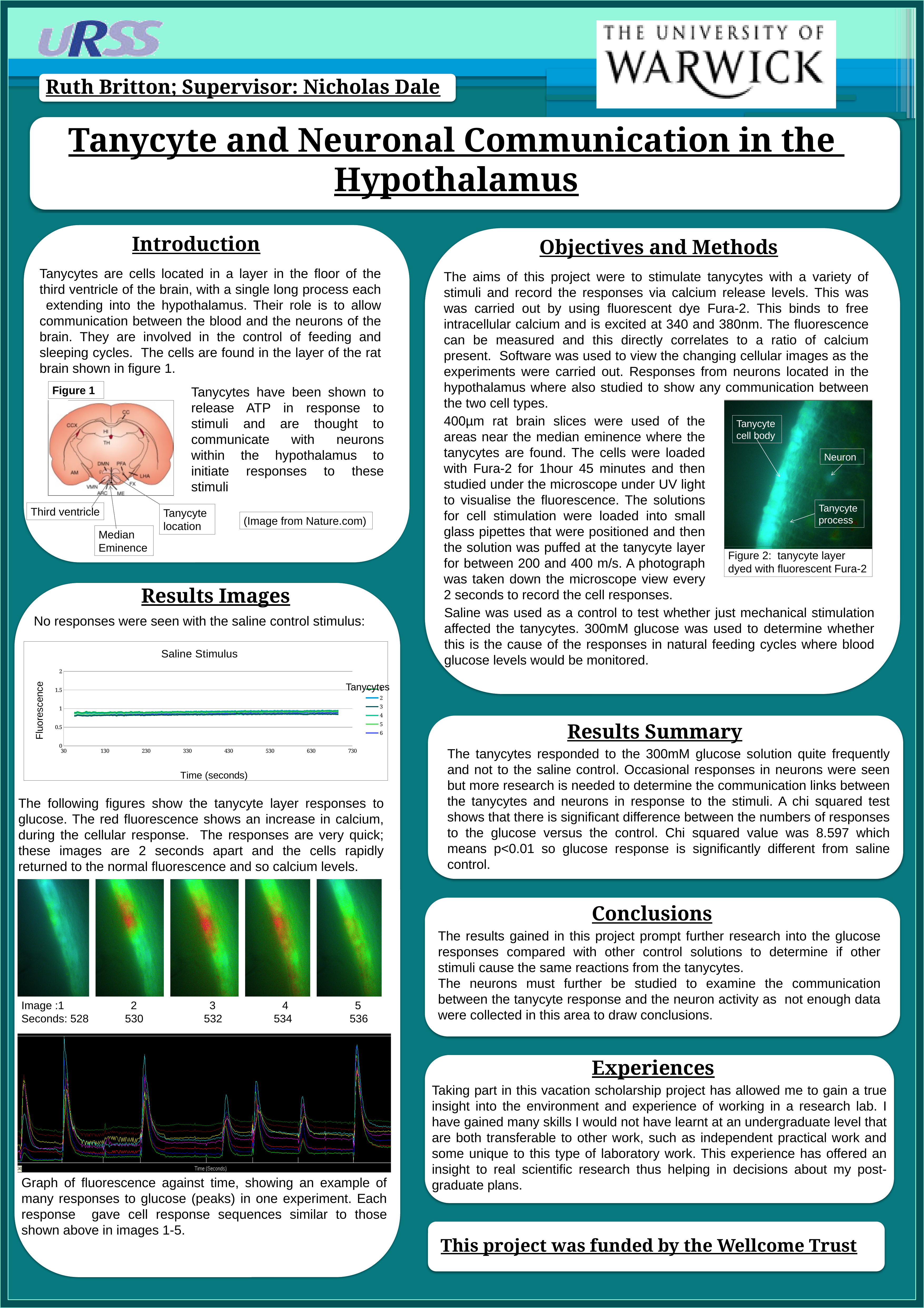
In the Saline Stimulus chart, is the fluorescence value for tanycyte 3 greater or less than 1.5? less In the Saline Stimulus chart, is the fluorescence value for tanycyte 2 greater or less than 1.5? less What is the title of the chart in the Results Images section? Saline Stimulus In the Saline Stimulus chart, is the fluorescence value for tanycyte 6 greater or less than 0.5? greater In the Saline Stimulus chart, what is the legend title above the series entries? Tanycytes In the Saline Stimulus chart, do the fluorescence values rise, fall, or stay roughly flat as time increases? stay roughly flat In the Saline Stimulus chart, what kind of chart is shown? line chart In the Saline Stimulus chart, how many series does the legend list? 5